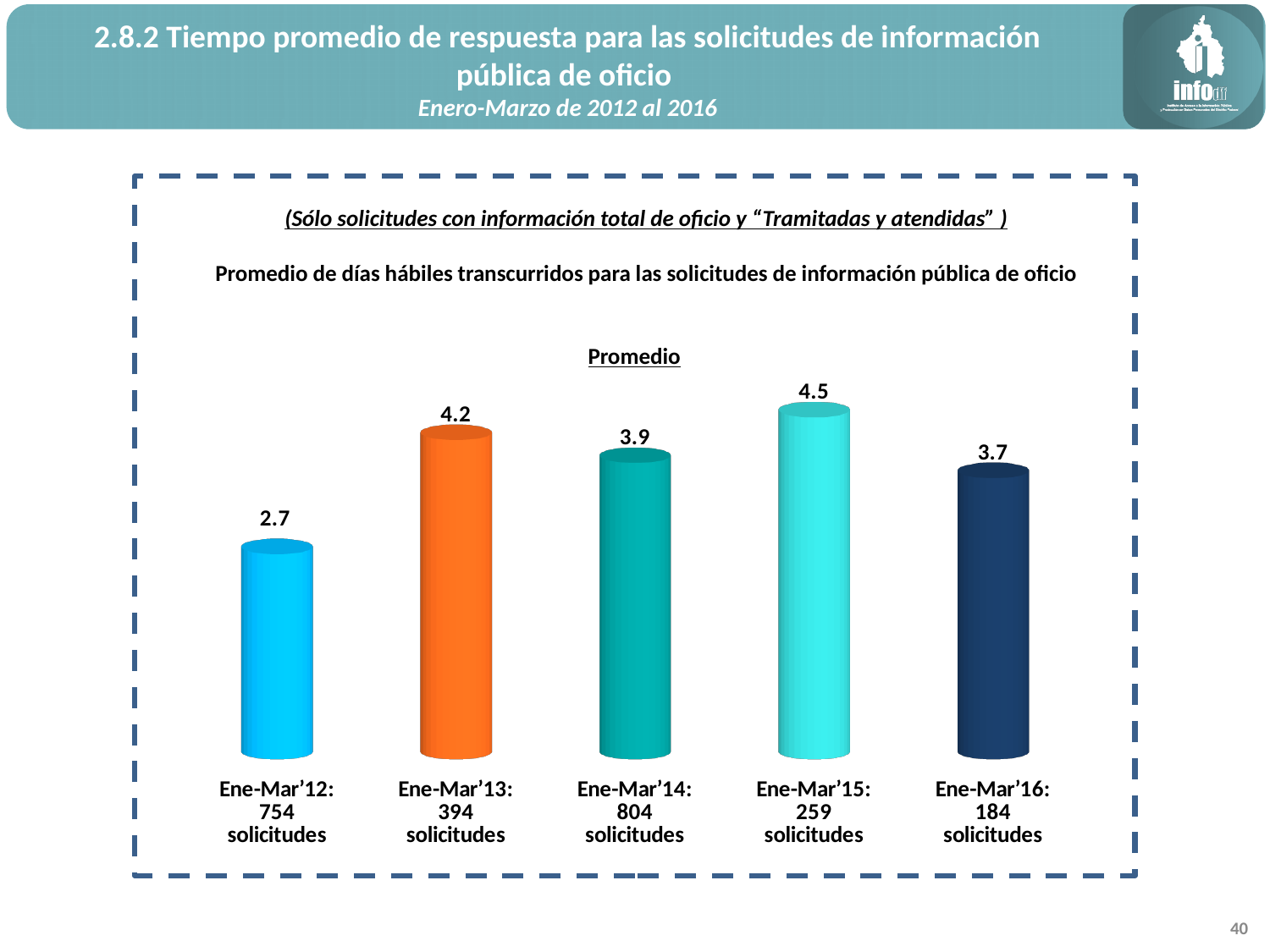
What is the average value shown for Ene-Mar'15? 4.5 What is the difference between the averages for Ene-Mar'13 and Ene-Mar'14? 0.3 How many solicitudes are indicated for Ene-Mar'14 in the category label? 804 solicitudes What is the average value shown for Ene-Mar'12? 2.7 Which period has the highest average? Ene-Mar'15 Which is larger, the average for Ene-Mar'13 or for Ene-Mar'16? Ene-Mar'13 What is the difference between the averages for Ene-Mar'15 and Ene-Mar'12? 1.8 What kind of chart is shown on the slide? Bar chart What is the average value shown for Ene-Mar'16? 3.7 How many periods (bars) are shown in the chart? 5 Which period has the lowest average? Ene-Mar'12 Does the average rise or fall from Ene-Mar'15 to Ene-Mar'16? Fall